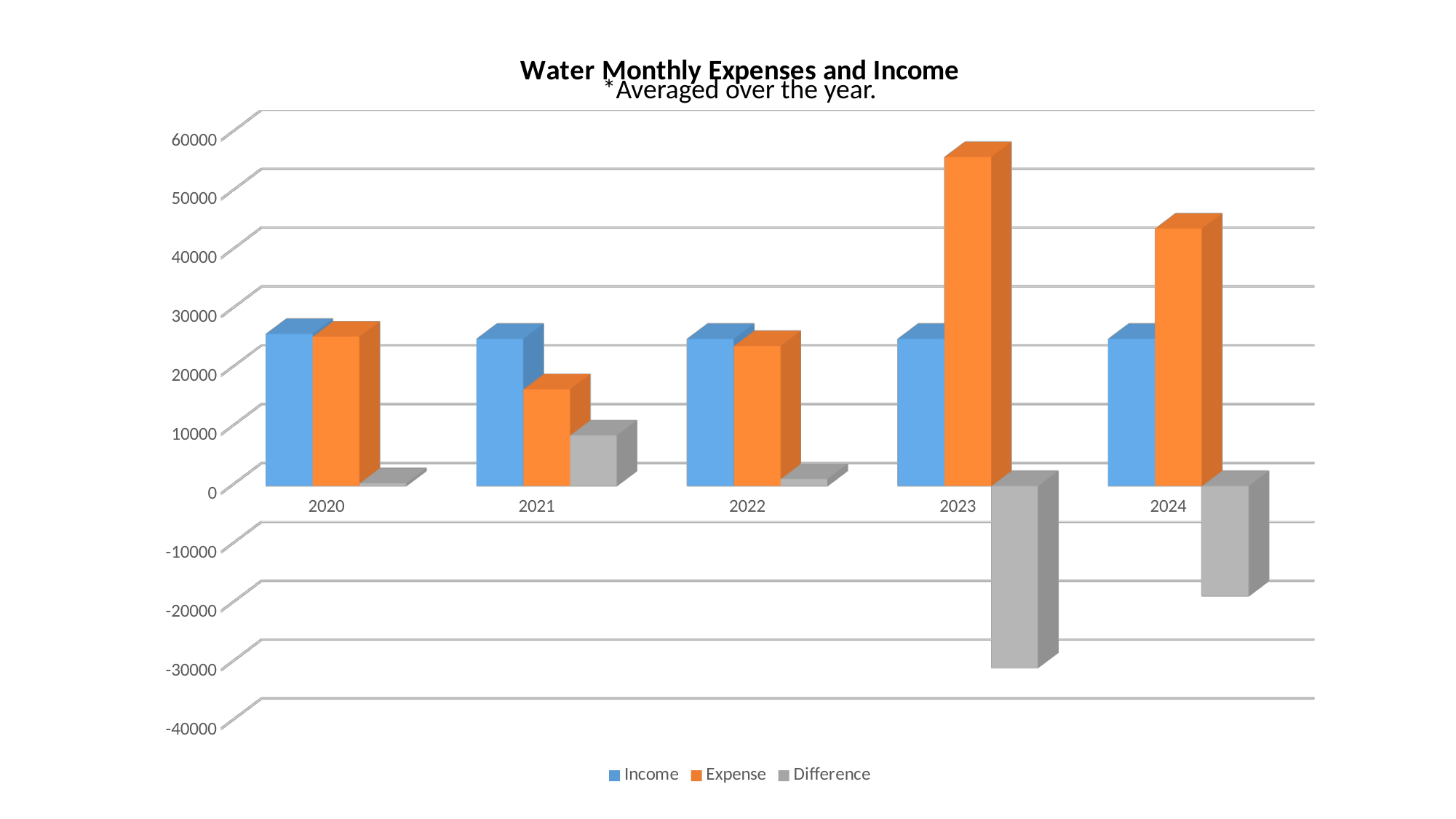
In which year is the Expense value highest? 2023 Which is larger, the Expense value for 2023 or the Expense value for 2024? 2023 Which is larger, the Expense value for 2021 or the Expense value for 2022? 2022 What kind of chart is shown on the slide? bar chart How many series does the legend list? 3 In which year is the Expense value lowest? 2021 What is the title of the chart? Water Monthly Expenses and Income Is the Expense value for 2021 greater or less than 20000? less How many years are shown on the x axis? 5 Is the Difference value for 2023 greater or less than -20000? less In which year is the Difference value lowest? 2023 Is the Expense value for 2023 greater or less than 50000? greater